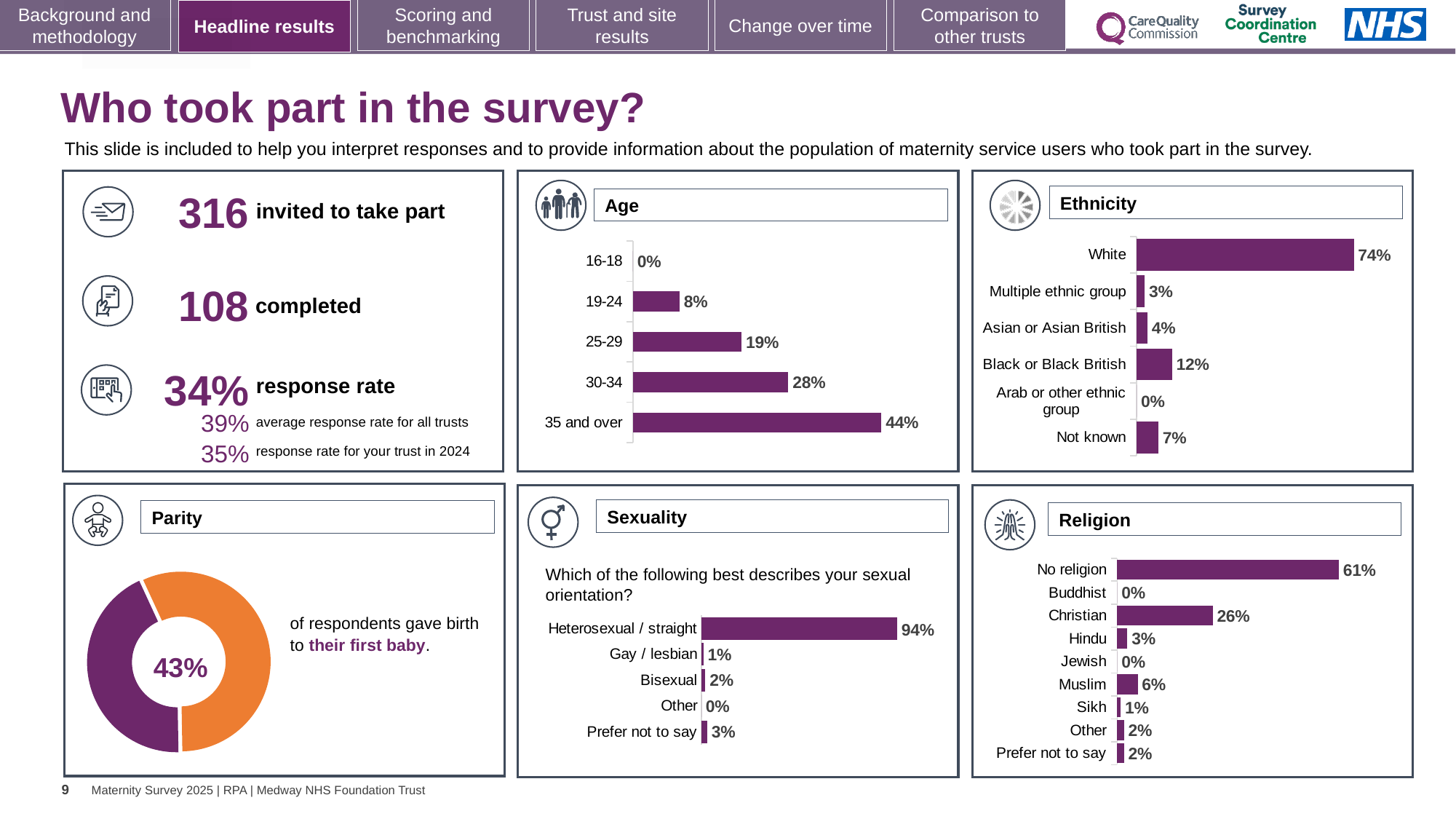
In the Ethnicity chart, how many categories are shown? 6 In the Parity chart, what percentage of respondents gave birth to their first baby? 43% In the Age chart, which age group has the lowest percentage? 16-18 In the Ethnicity chart, which is larger: Black or Black British or Not known? Black or Black British What kind of chart is the Parity chart? Doughnut chart In the Sexuality chart, what percentage of respondents answered Heterosexual / straight? 94% In the Age chart, what percentage of respondents were aged 35 and over? 44% In the Ethnicity chart, which category has the highest percentage? White In the Religion chart, what percentage of respondents were Christian? 26% In the Ethnicity chart, what percentage of respondents were White? 74% In the Religion chart, how many categories are shown? 9 In the Age chart, what is the difference between the 30-34 and 25-29 groups? 9%